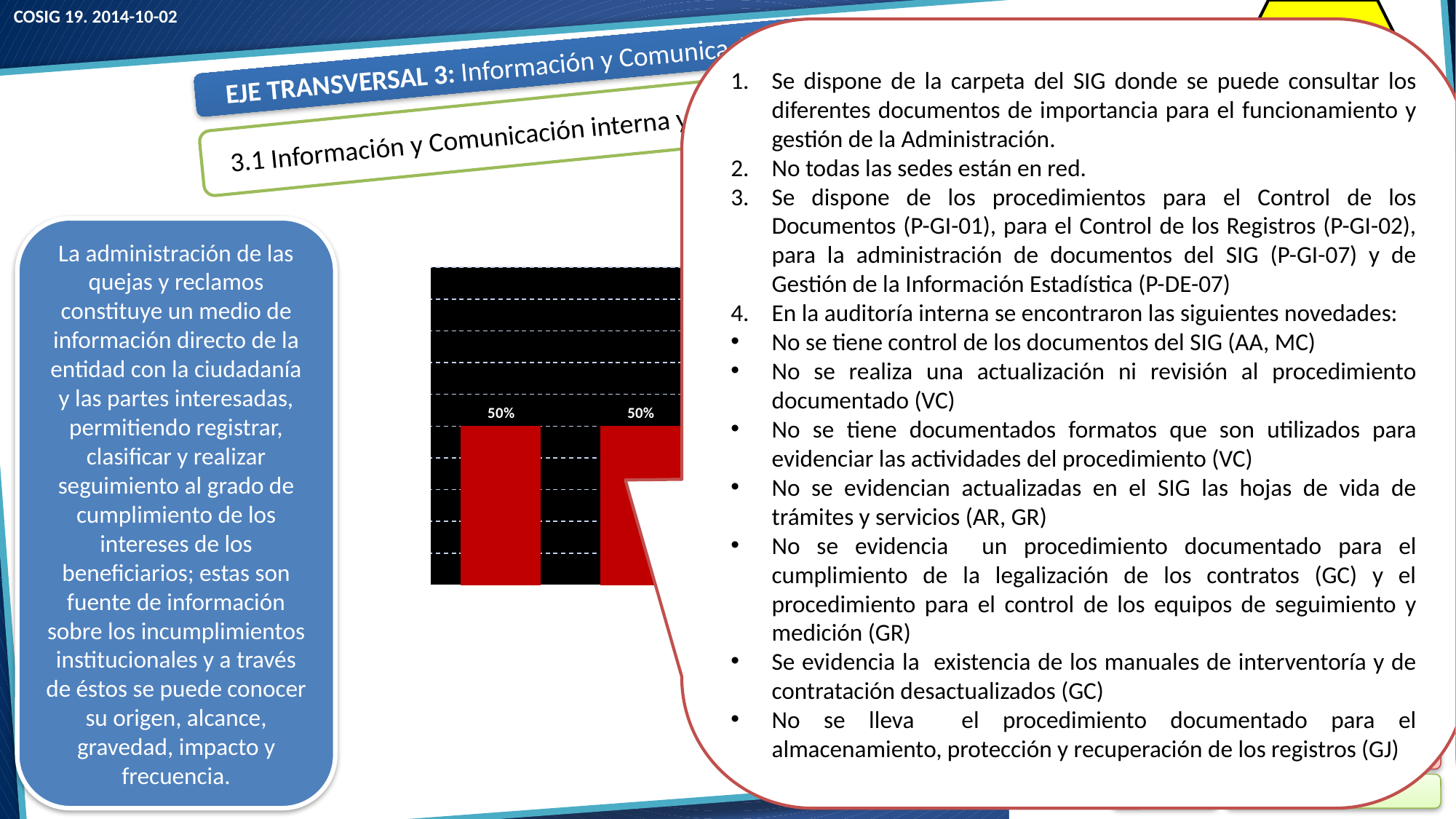
What value is labelled on the left bar of the chart? 50% What is the difference between the values of the two labelled bars in the chart? 0% What value is labelled on the right bar of the chart? 50% What kind of chart is shown on the slide? bar chart How many bars are visible in the chart? 2 What colour are the bars in the chart? red What colour is the background of the chart's plot area? black Is the left bar of the chart larger, smaller, or equal to the right bar? equal